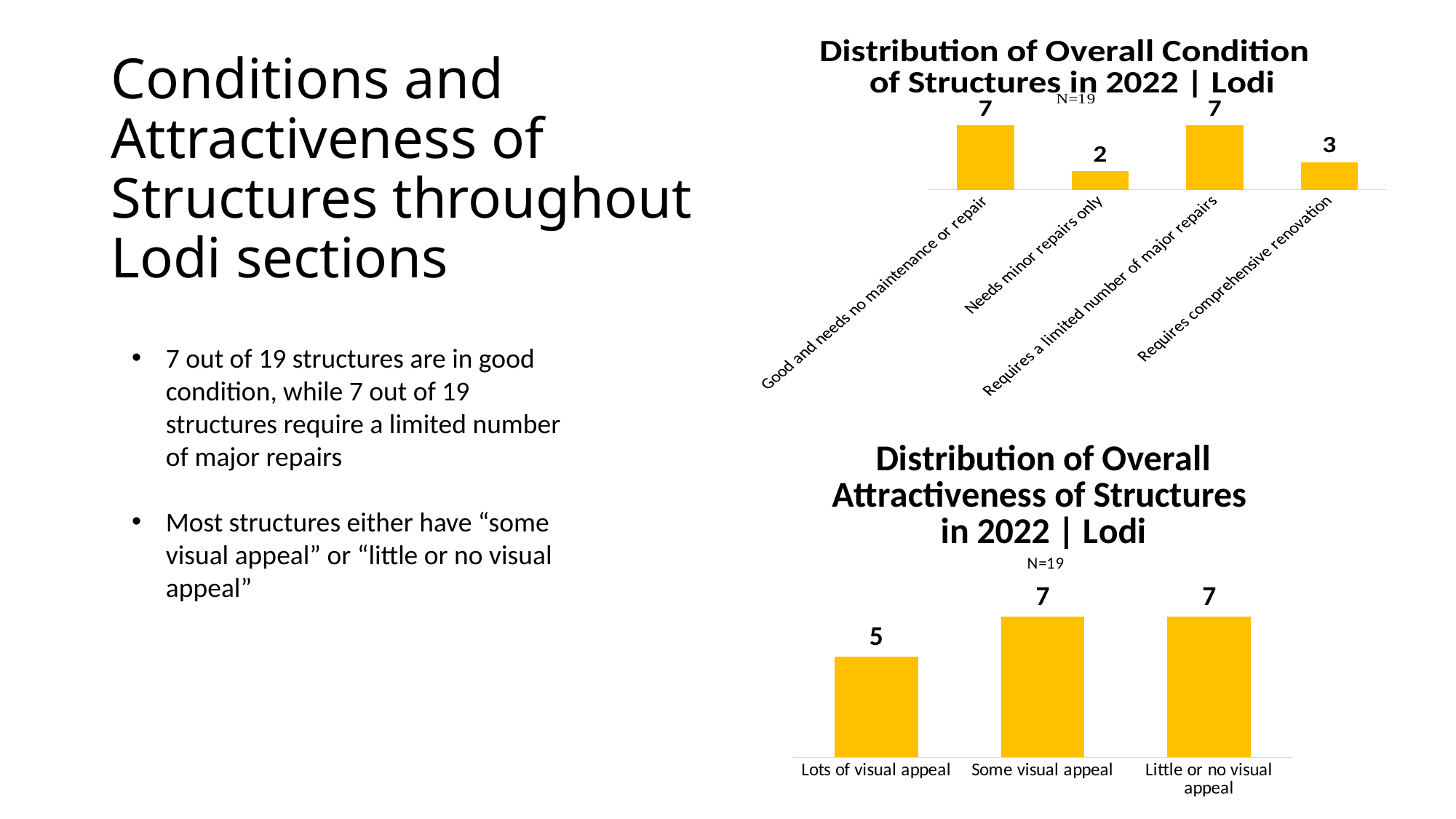
In the 'Distribution of Overall Attractiveness of Structures in 2022 | Lodi' chart, what is the value for 'Some visual appeal'? 7 In the 'Distribution of Overall Attractiveness of Structures in 2022 | Lodi' chart, which category has the lowest value? Lots of visual appeal In the 'Distribution of Overall Condition of Structures in 2022 | Lodi' chart, which is larger: 'Requires comprehensive renovation' or 'Needs minor repairs only'? Requires comprehensive renovation In the 'Distribution of Overall Condition of Structures in 2022 | Lodi' chart, what is the value for 'Requires comprehensive renovation'? 3 In the 'Distribution of Overall Condition of Structures in 2022 | Lodi' chart, how many categories are shown? 4 In the 'Distribution of Overall Attractiveness of Structures in 2022 | Lodi' chart, how many categories are shown? 3 In the 'Distribution of Overall Condition of Structures in 2022 | Lodi' chart, which category has the lowest value? Needs minor repairs only In the 'Distribution of Overall Attractiveness of Structures in 2022 | Lodi' chart, what is the value for 'Lots of visual appeal'? 5 What kind of chart is the 'Distribution of Overall Attractiveness of Structures in 2022 | Lodi' chart? Bar chart In the 'Distribution of Overall Attractiveness of Structures in 2022 | Lodi' chart, what is the difference between 'Some visual appeal' and 'Lots of visual appeal'? 2 In the 'Distribution of Overall Condition of Structures in 2022 | Lodi' chart, what is the value for 'Needs minor repairs only'? 2 In the 'Distribution of Overall Condition of Structures in 2022 | Lodi' chart, what is the difference between 'Good and needs no maintenance or repair' and 'Requires comprehensive renovation'? 4